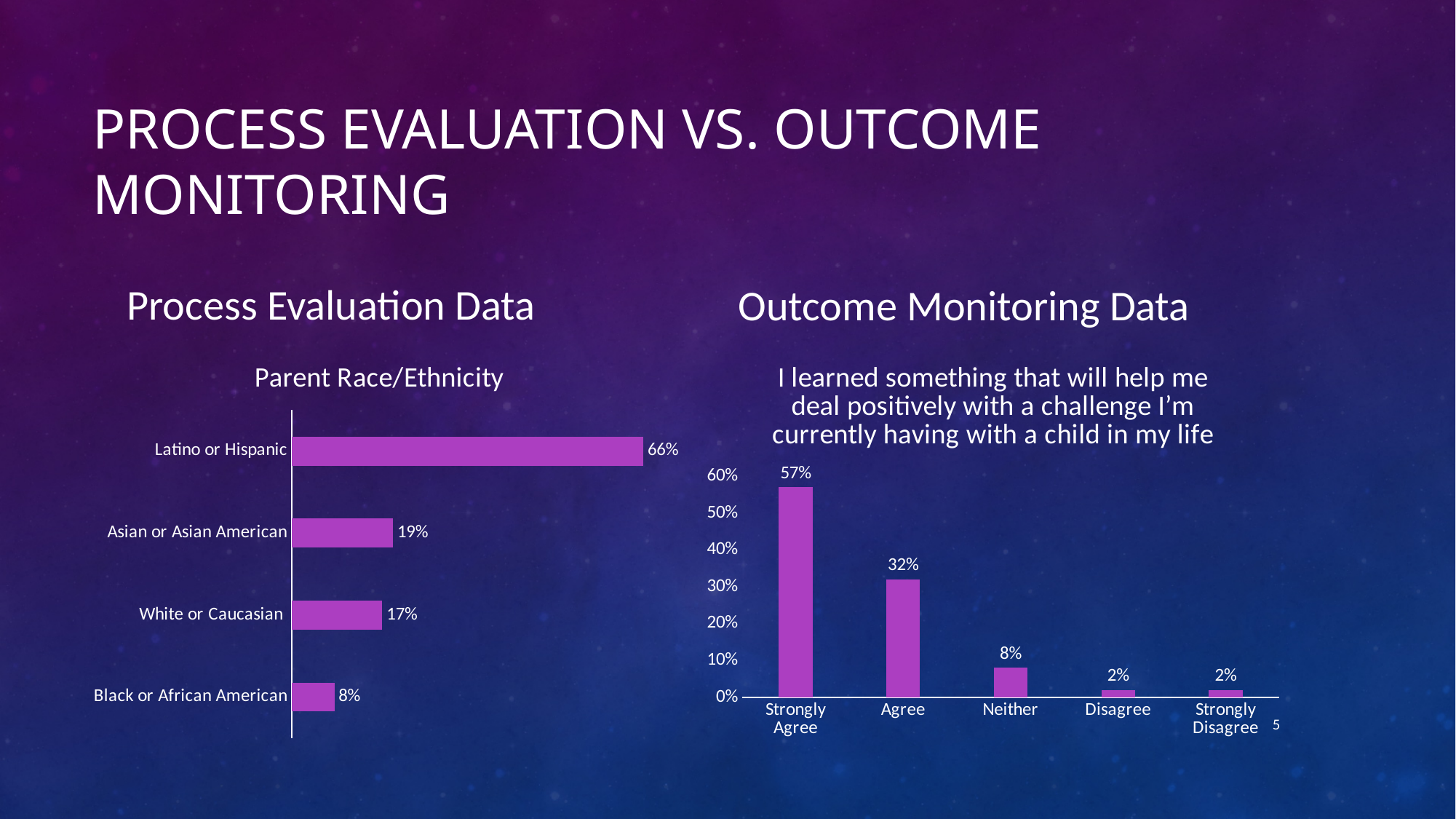
In the Parent Race/Ethnicity chart, how many categories are shown? 4 In the Parent Race/Ethnicity chart, what is the value for Latino or Hispanic? 66% In the chart on the right (I learned something that will help me...), which category has the highest value? Strongly Agree In the Parent Race/Ethnicity chart, what is the value for White or Caucasian? 17% In the chart on the right (I learned something that will help me...), what is the value for Agree? 32% In the Parent Race/Ethnicity chart, which category has the lowest value? Black or African American In the chart on the right (I learned something that will help me...), what is the difference between Strongly Agree and Agree? 25% In the Parent Race/Ethnicity chart, what is the difference between Asian or Asian American and White or Caucasian? 2% In the chart on the right (I learned something that will help me...), which is larger, Neither or Disagree? Neither What kind of chart is the Parent Race/Ethnicity chart? Bar chart In the chart on the right (I learned something that will help me...), do the values rise or fall from Strongly Agree to Strongly Disagree? Fall In the chart on the right (I learned something that will help me...), how many categories are on the x axis? 5